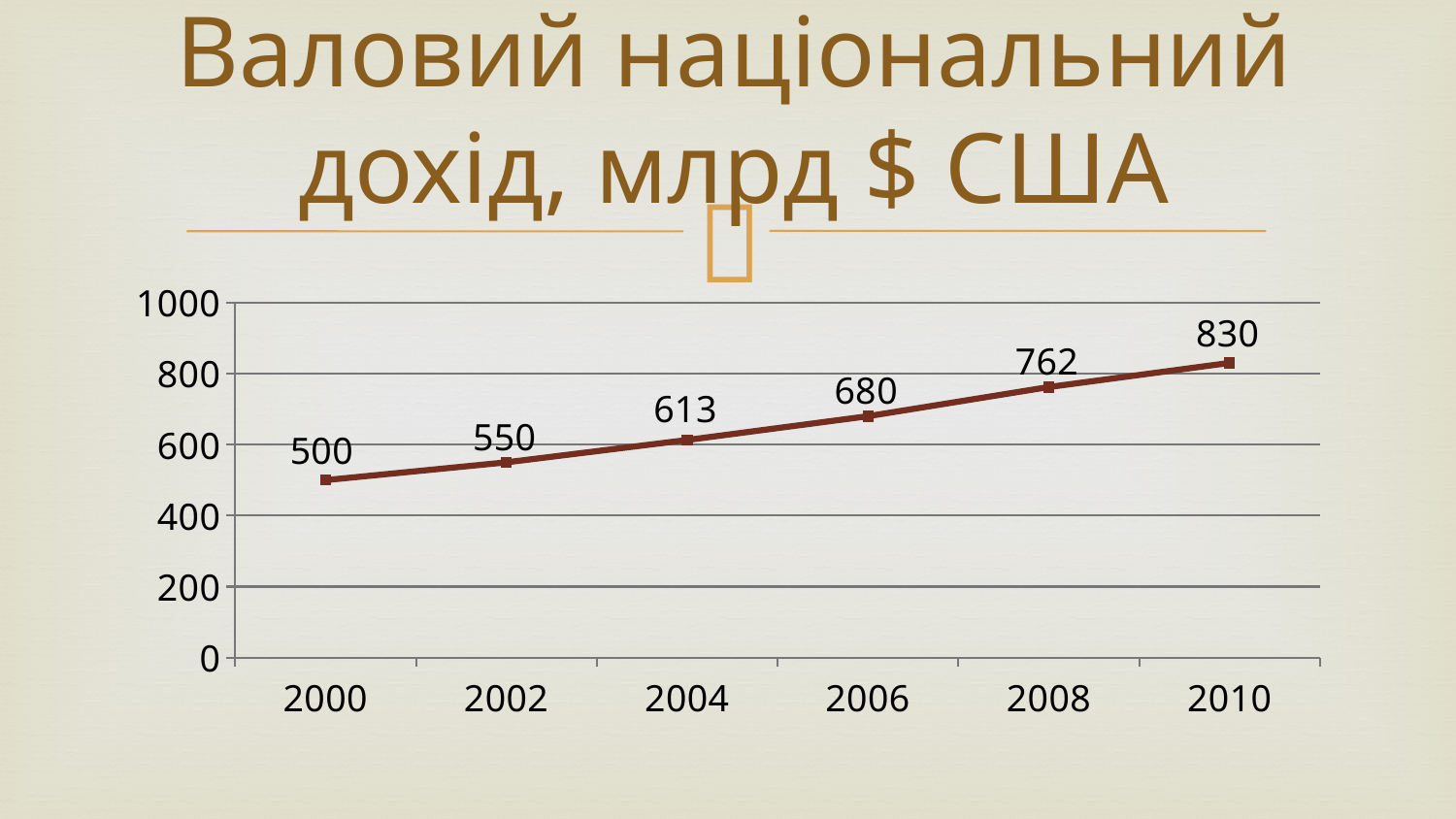
Is the value for 2010 greater or less than 800? greater Do the values rise or fall from 2000 to 2010? rise Which year has the lowest value? 2000 What is the difference between the values for 2010 and 2000? 330 What is the difference between the values for 2006 and 2002? 130 How many data points are plotted on the chart? 6 What is the value for 2004? 613 What kind of chart is shown on the slide? line chart Which is larger, the value for 2006 or the value for 2008? 2008 What is the value for 2008? 762 Which year has the highest value? 2010 What is the value for 2000? 500